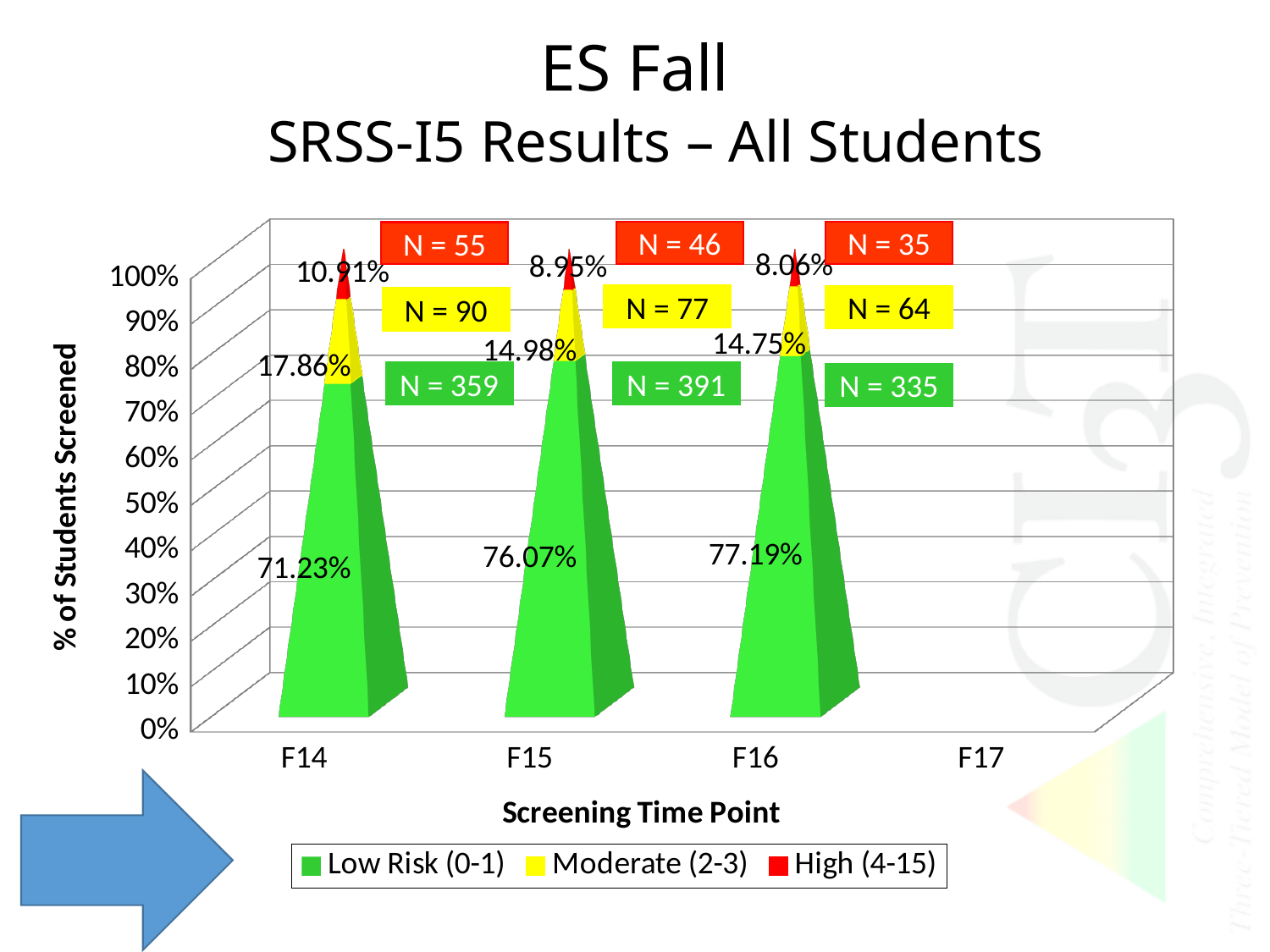
Which screening time point has the lowest High (4-15) percentage? F16 How many screening time points have data plotted? 3 What is the difference between the Low Risk (0-1) percentages for F16 and F14? 5.96% What is the label of the x axis? Screening Time Point Which is larger, the High (4-15) percentage for F14 or for F15? F14 What is the High (4-15) percentage for F16? 8.06% What is the Moderate (2-3) percentage for F15? 14.98% Which screening time point has the highest Low Risk (0-1) percentage? F16 What is the difference between the Moderate (2-3) percentages for F14 and F16? 3.11% How many series does the legend list? 3 Does the Low Risk (0-1) percentage rise or fall from F14 to F16? rise What is the Low Risk (0-1) percentage for F14? 71.23%